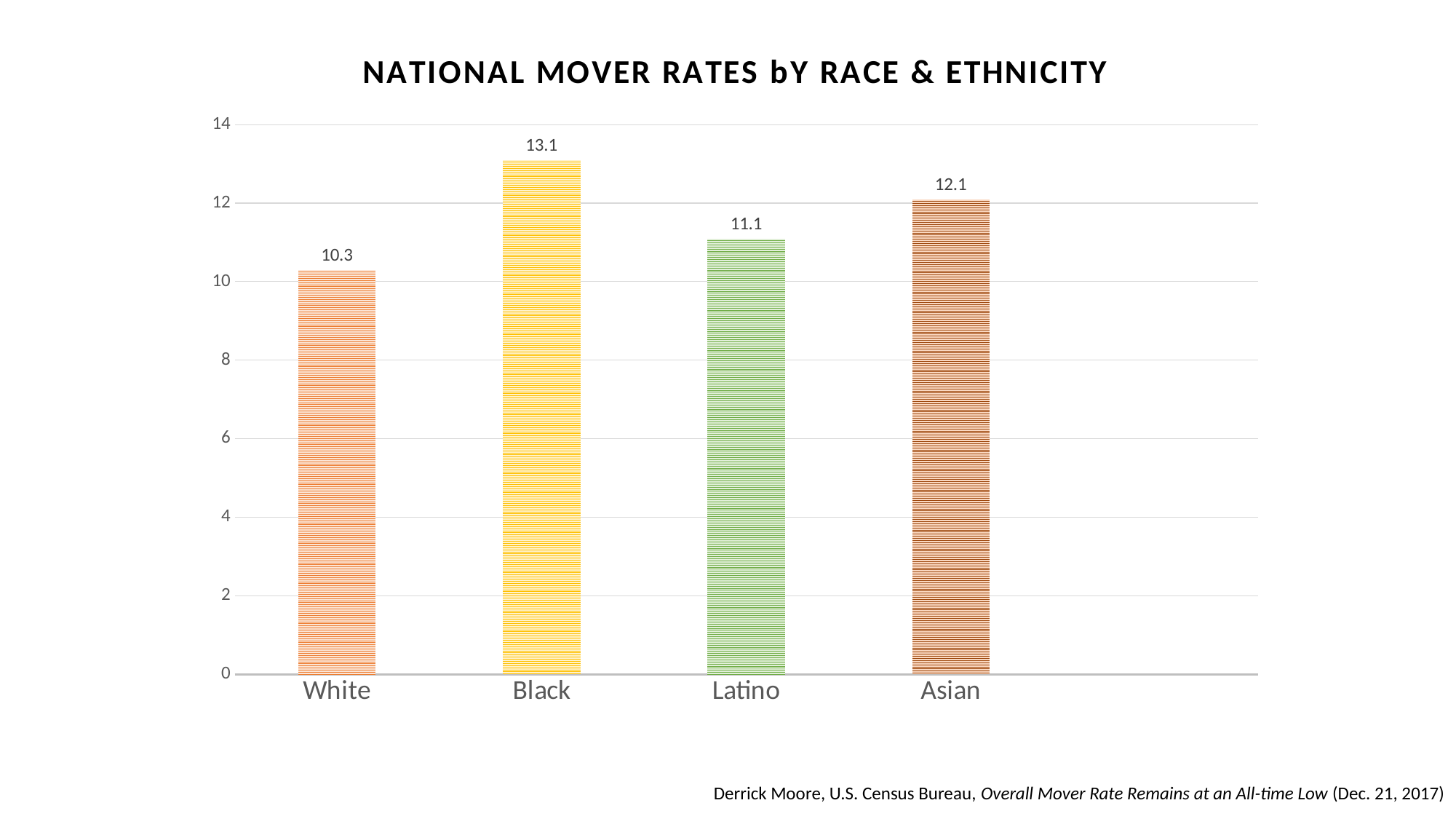
What type of chart is shown? Bar chart What is the difference between the mover rates for Black and White? 2.8 What is the mover rate for Latino? 11.1 Is the value for Black greater or less than 12? greater What is the difference between the mover rates for Asian and Latino? 1.0 Which group has the lowest mover rate? White Which has a higher mover rate, Latino or Asian? Asian What is the mover rate for White? 10.3 What is the mover rate for Black? 13.1 How many groups are shown on the chart? 4 What is the mover rate for Asian? 12.1 Which group has the highest mover rate? Black